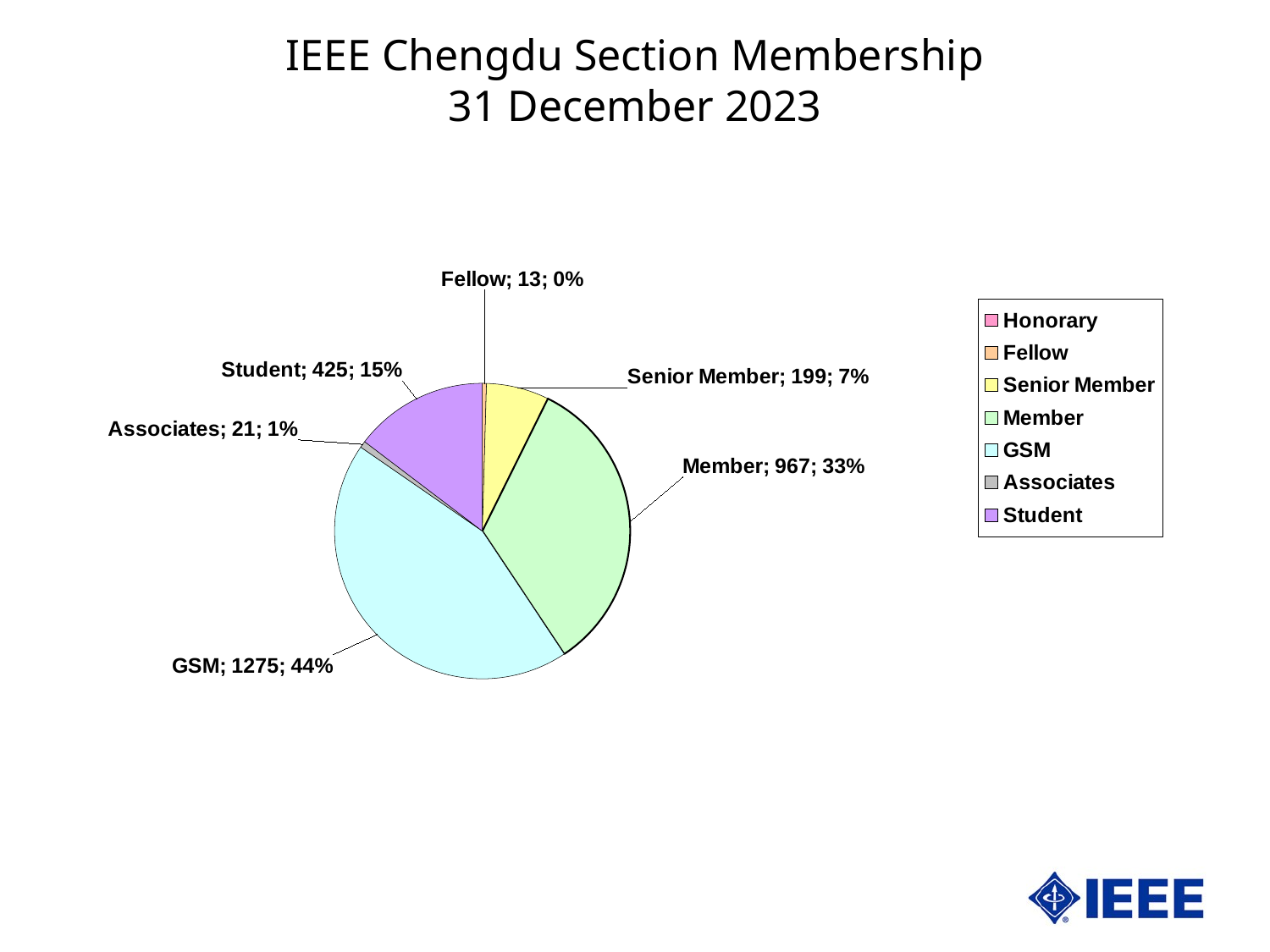
What percentage share of the pie does Student hold? 15% What is the membership count for GSM? 1275 What is the difference between the GSM count and the Member count? 308 Which is larger, the Student count or the Senior Member count? Student Which labelled category has the smallest count? Fellow What is the membership count for Associates? 21 What kind of chart is shown on the slide? Pie chart How many entries does the legend list? 7 What is the title of the chart? IEEE Chengdu Section Membership 31 December 2023 What is the membership count for Senior Member? 199 Which category has the largest slice of the pie? GSM What percentage share of the pie does Member hold? 33%